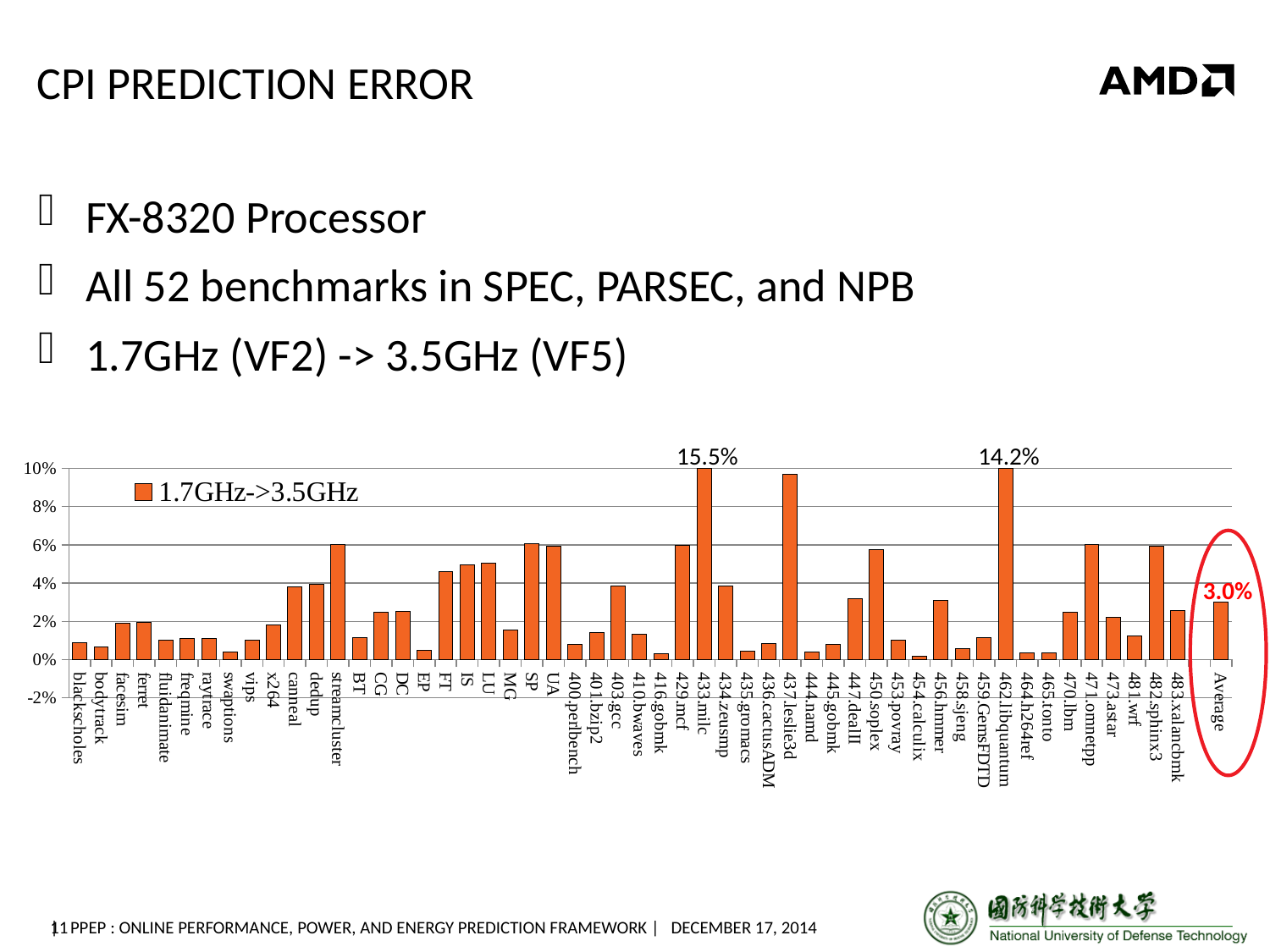
What is the CPI prediction error shown for 462.libquantum? 14.2% What kind of chart is shown on the slide? Bar chart What is the CPI prediction error shown for 433.milc? 15.5% Is the value for 437.leslie3d greater or less than 8%? greater How many series does the legend list? 1 Which has a larger CPI prediction error, 433.milc or 462.libquantum? 433.milc Is the value for streamcluster greater or less than 4%? greater Which benchmark has the highest CPI prediction error? 433.milc Is the value for 454.calculix greater or less than 2%? less What is the difference between the values for 433.milc and 462.libquantum? 1.3% Which has a larger CPI prediction error, 437.leslie3d or 429.mcf? 437.leslie3d What is the value shown for the Average bar? 3.0%